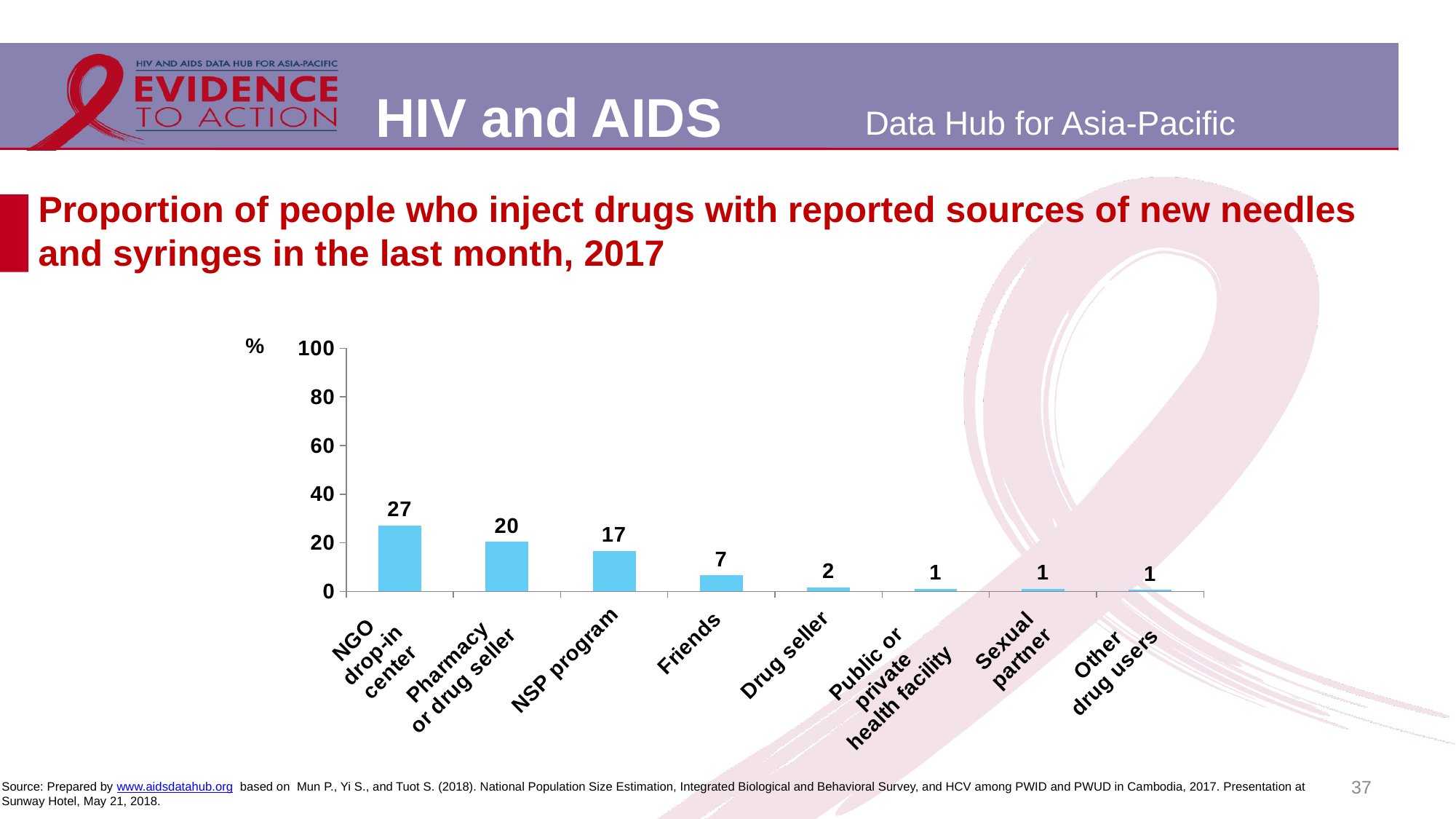
What kind of chart is shown on the slide? bar chart Which source has the highest value? NGO drop-in center Which is larger, the value for Pharmacy or drug seller or the value for Friends? Pharmacy or drug seller What is the value for Drug seller? 2 Is the value for NGO drop-in center greater or less than 40? less What is the value for Pharmacy or drug seller? 20 What is the difference between the values for NGO drop-in center and NSP program? 10 How many sources are shown on the x axis? 8 What is the value for Friends? 7 What is the value for NGO drop-in center? 27 What is the value for NSP program? 17 What unit is shown on the y axis of the chart? %